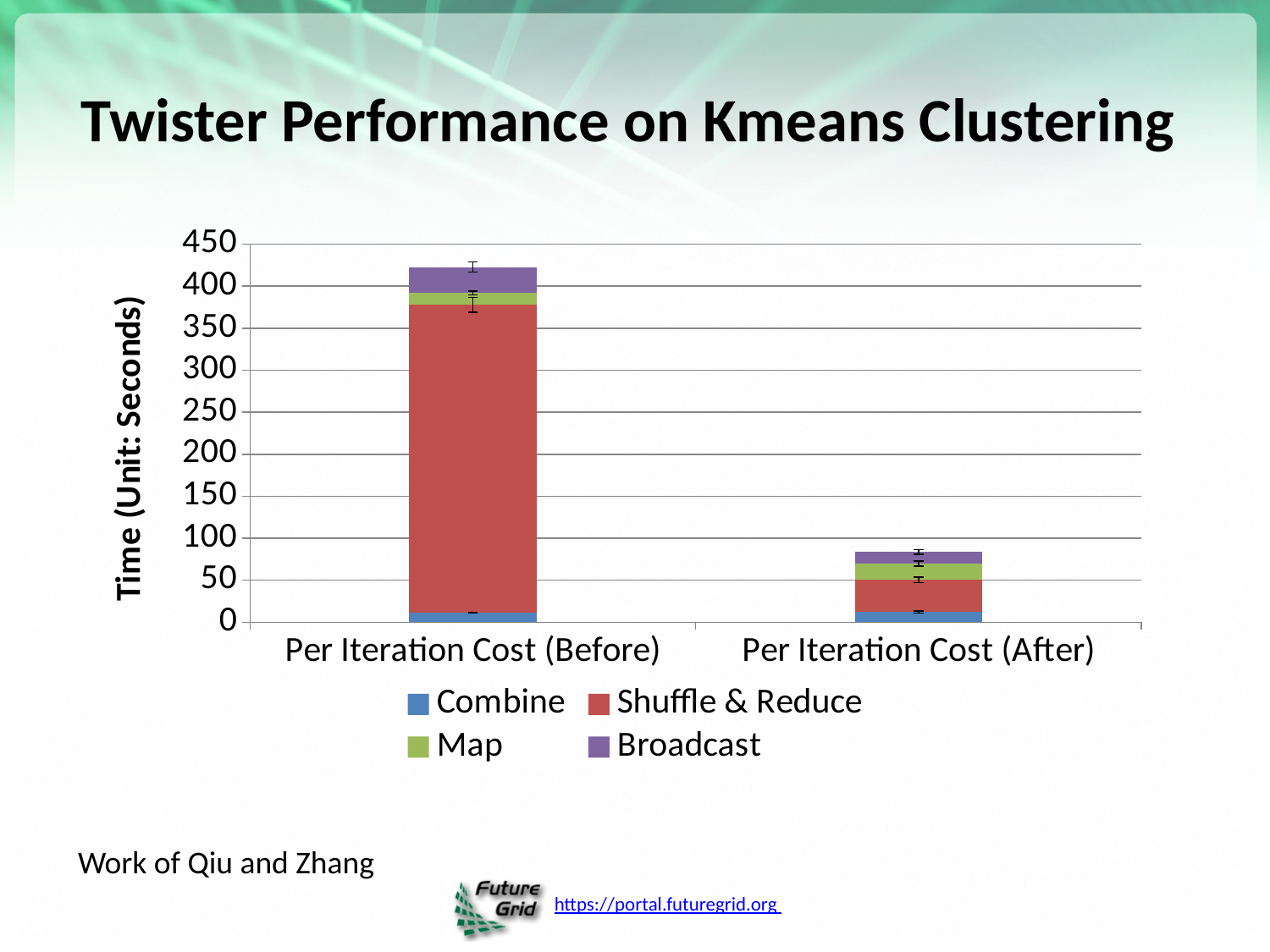
Is the Shuffle & Reduce segment for Per Iteration Cost (Before) greater or less than 300? greater What is the label of the y axis? Time (Unit: Seconds) What kind of chart is shown on the slide? stacked bar chart Is the total value for Per Iteration Cost (After) greater or less than 50? greater Which category has the lowest total bar? Per Iteration Cost (After) What is the title of the chart on the slide? Twister Performance on Kmeans Clustering Is the Combine segment for Per Iteration Cost (Before) greater or less than 50? less How many series does the legend list? 4 How many categories are shown on the x axis? 2 Which category has the higher total bar, Per Iteration Cost (Before) or Per Iteration Cost (After)? Per Iteration Cost (Before)